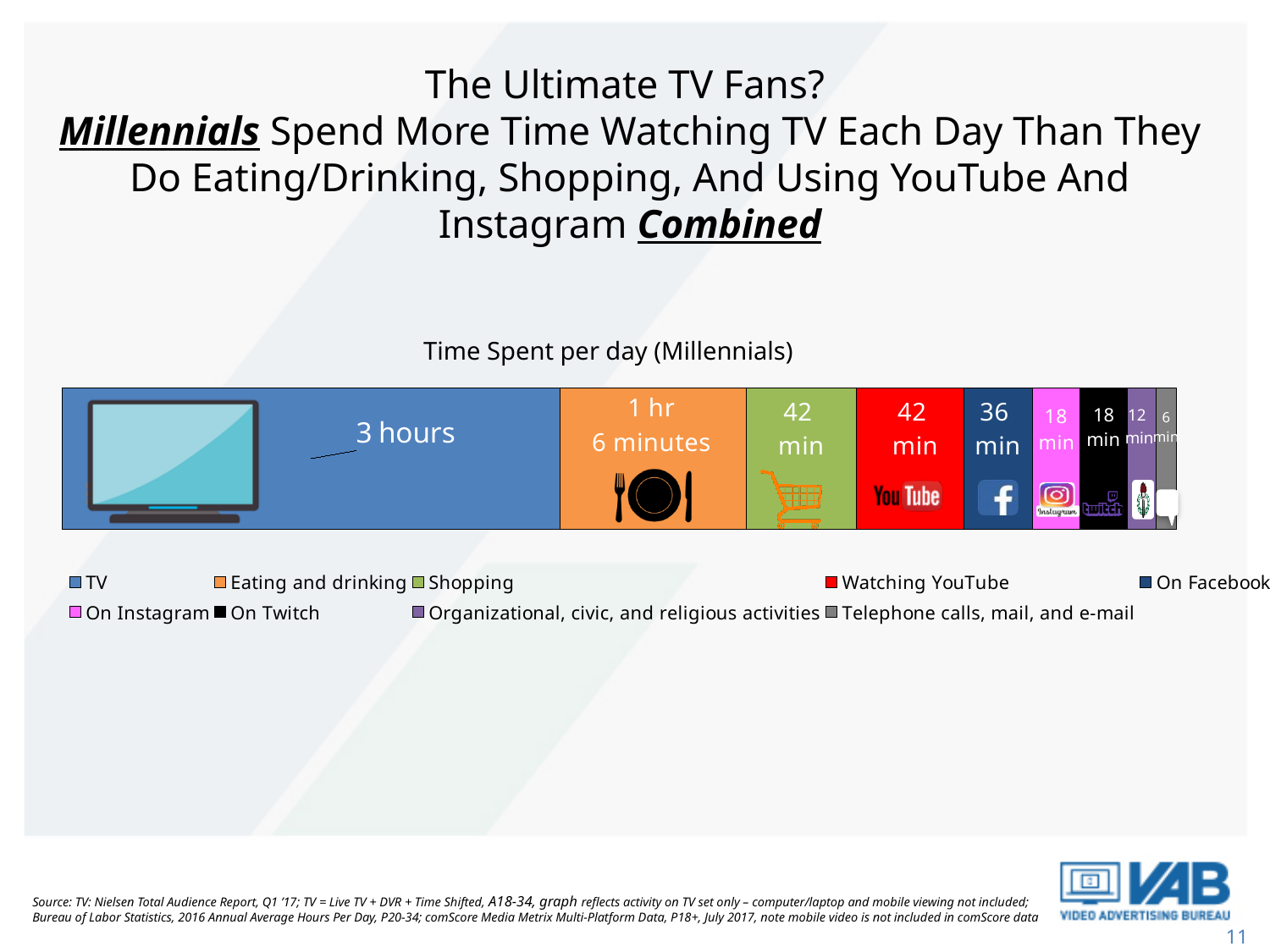
Which is larger, the time spent On Facebook or the time spent On Instagram? On Facebook How many series does the legend of the chart list? 9 Which activity has the largest segment in the stacked bar? TV What is the difference between the time spent On Facebook and the time spent On Instagram? 18 min What is the value shown for Watching YouTube? 42 min How much time per day do Millennials spend on TV according to the chart? 3 hours What is the difference between the time spent Watching YouTube and the time spent On Facebook? 6 min What kind of chart is shown on the slide? Stacked bar chart What is the value shown for Eating and drinking? 1 hr 6 minutes What is the chart title of the bar chart on the slide? Time Spent per day (Millennials) What is the value shown for On Facebook? 36 min Which activity has the smallest segment in the stacked bar? Telephone calls, mail, and e-mail